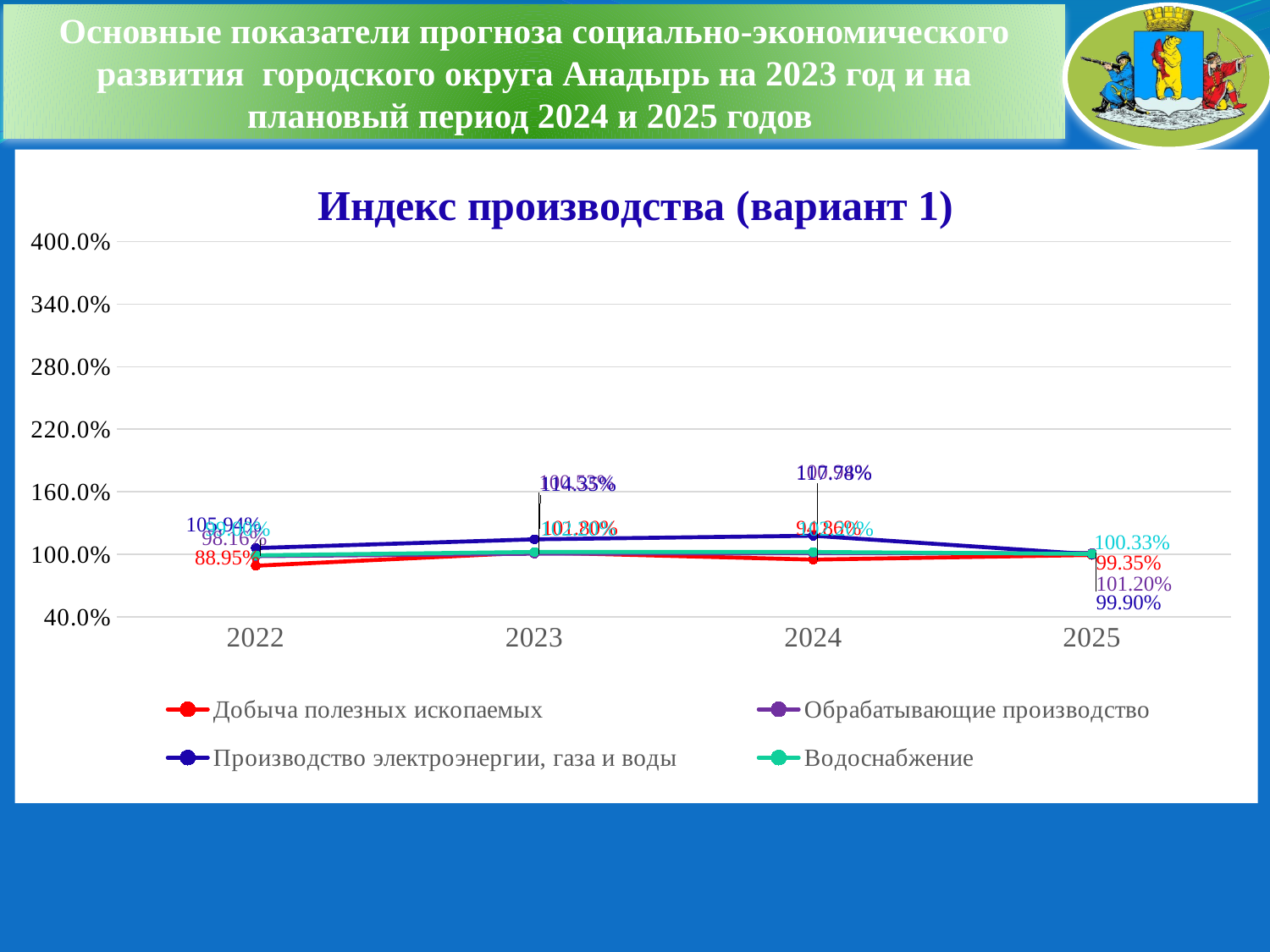
What is the value for Добыча полезных ископаемых in 2023? 101.80% What is the value for Добыча полезных ископаемых in 2024? 94.86% What is the value for Добыча полезных ископаемых in 2022? 88.95% How many years are shown on the x axis? 4 What is the value for Водоснабжение in 2025? 100.33% Is the value for Добыча полезных ископаемых in 2024 greater or less than 160.0%? less What kind of chart is shown on the slide? line chart In 2025, which is larger: Обрабатывающие производство or Водоснабжение? Обрабатывающие производство What is the title of the chart? Индекс производства (вариант 1) How many series does the legend list? 4 What is the difference between the Добыча полезных ископаемых values in 2023 and 2022? 12.85% In which year is the value for Добыча полезных ископаемых lowest? 2022